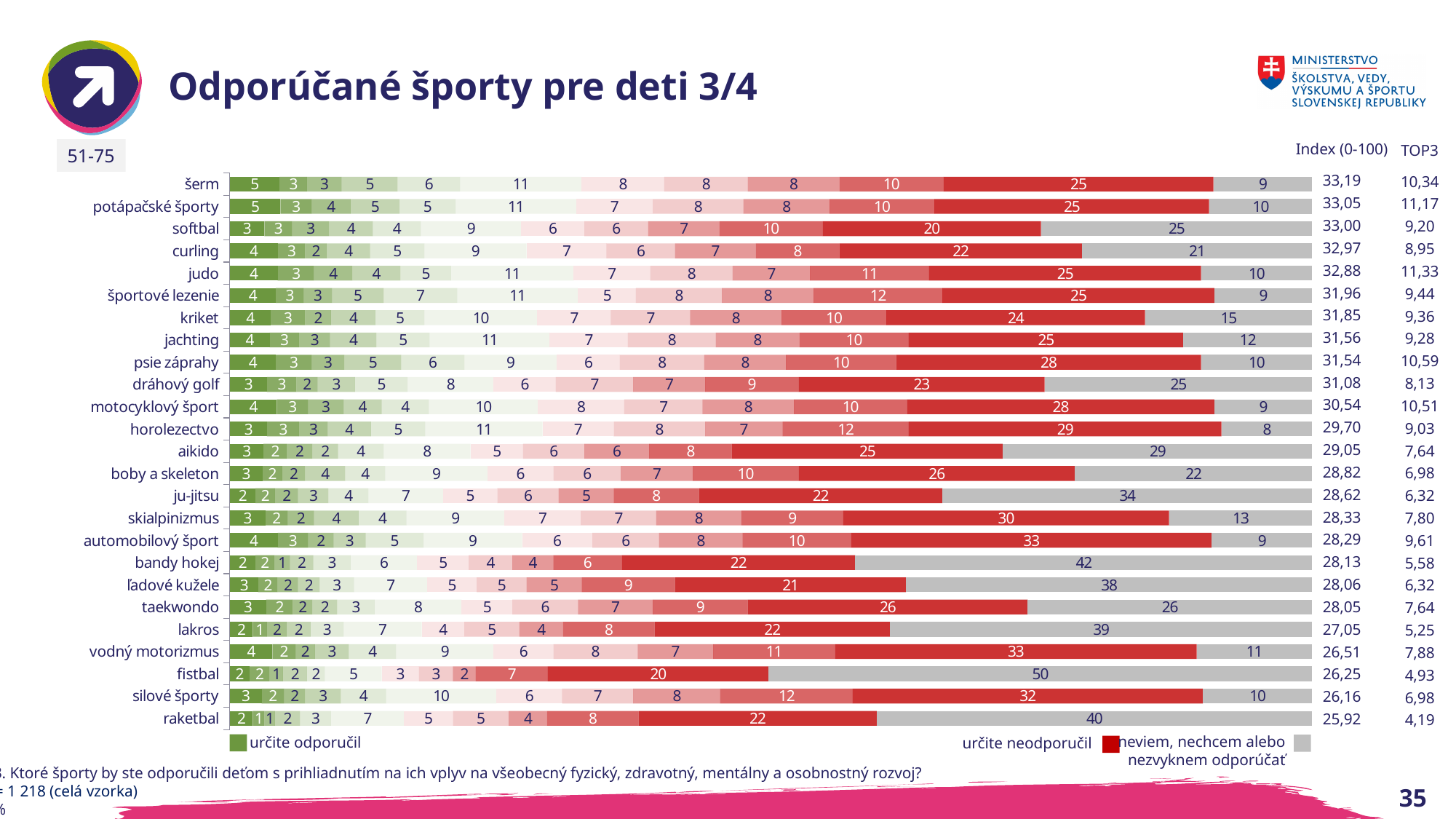
What kind of chart is shown on the slide? bar chart What is the TOP3 value for judo? 11,33 How many sports are listed in the chart? 25 What is the difference between the grey segment values of bandy hokej and raketbal? 2 Which sport has the largest grey 'neviem, nechcem alebo nezvyknem odporúčať' segment? fistbal What is the value of the dark red 'určite neodporučil' segment for automobilový šport? 33 Which has a larger 'určite neodporučil' segment: horolezectvo or skialpinizmus? skialpinizmus Which sport has the lowest Index (0-100) value? raketbal What is the value of the grey 'neviem, nechcem alebo nezvyknem odporúčať' segment for fistbal? 50 What is the first legend entry shown below the chart? určite odporučil Which sport has the lowest TOP3 value? raketbal What is the Index (0-100) value for šerm? 33,19